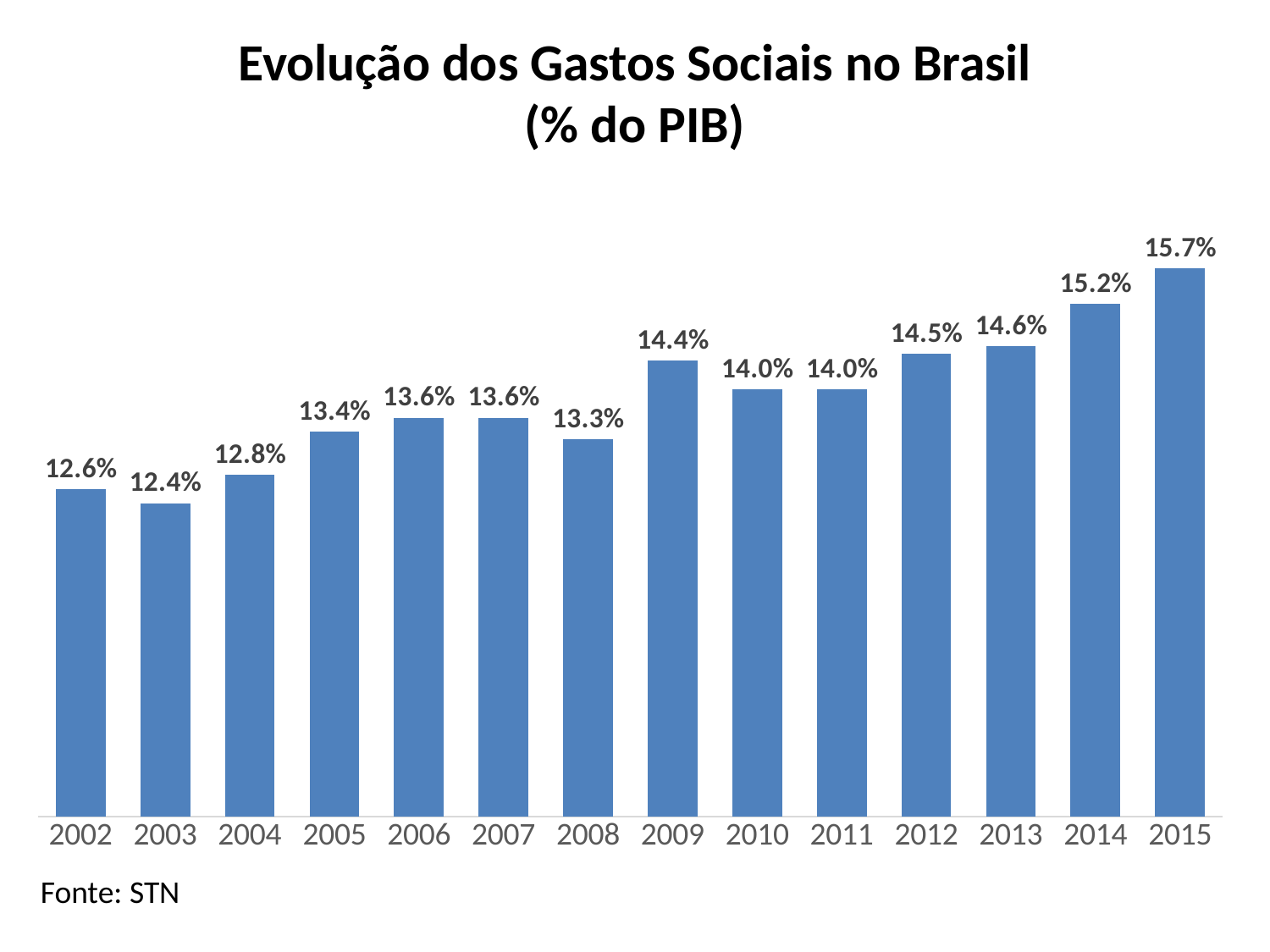
What is the source cited below the chart? STN What is the difference between the values for 2009 and 2008? 1.1% What is the value for 2009? 14.4% What is the difference between the values for 2015 and 2002? 3.1% Do the values generally rise or fall from 2002 to 2015? rise What is the value for 2003? 12.4% Which year has the highest value? 2015 What kind of chart is this? bar chart What is the value for 2015? 15.7% How many years are shown on the x axis? 14 Which is larger, the value for 2008 or the value for 2007? 2007 Which year has the lowest value? 2003